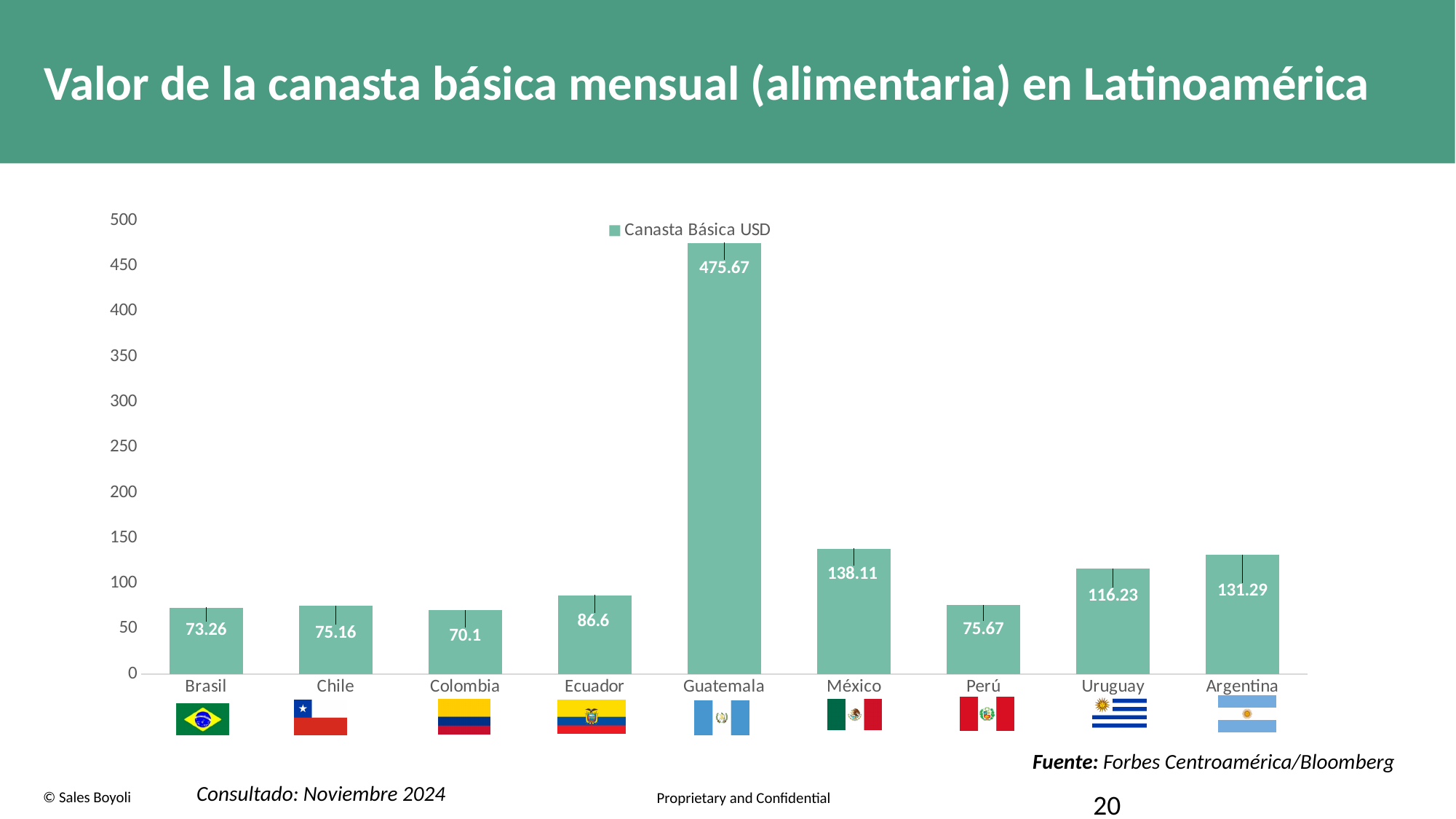
What is the difference between the values for Guatemala and México? 337.56 Which country has the highest value? Guatemala What is the value for Uruguay? 116.23 Which is larger, the value for Uruguay or the value for Ecuador? Uruguay Which country has the lowest value? Colombia What is the value for México? 138.11 How many countries are shown on the chart? 9 What kind of chart is shown on the slide? bar chart Is the value for Guatemala greater or less than 450? greater What is the value for Guatemala? 475.67 What is the value for Colombia? 70.1 What is the difference between the values for Argentina and Uruguay? 15.06